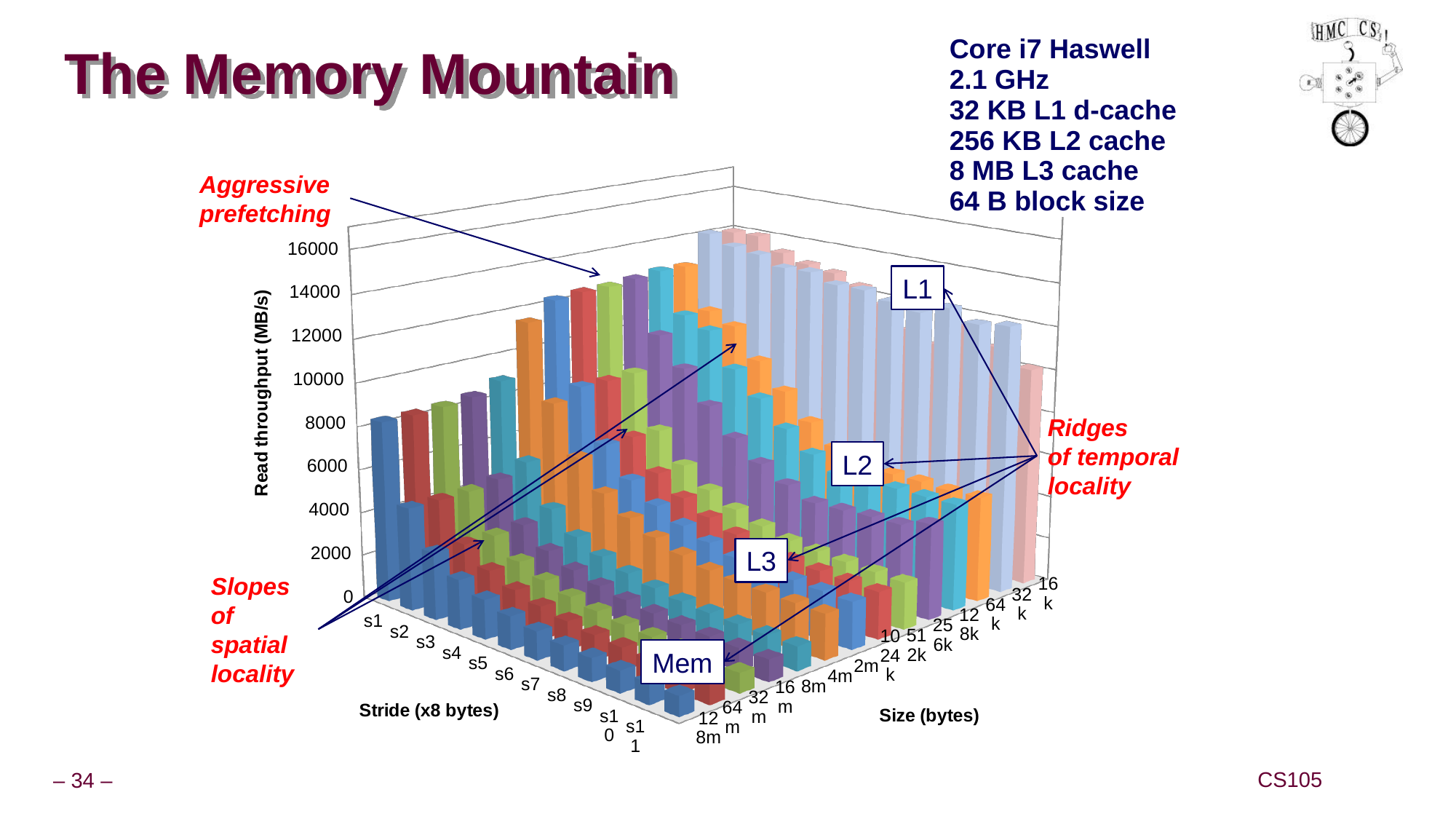
For the front-most size row, which has the larger read throughput: stride s1 or stride s11? s1 Is the read throughput for stride s1 at size 16k greater or less than 12000? greater How many stride categories are shown along the Stride (x8 bytes) axis? 11 Is the read throughput for stride s11 in the front-most size row greater or less than 2000? less For the front-most size row (largest working-set size), does read throughput rise or fall as stride increases from s1 to s11? fall What kind of chart is shown on the slide? 3D bar chart For the front-most size row, which stride has the highest read throughput? s1 What is the label of the vertical axis of the chart? Read throughput (MB/s) What is the highest tick value shown on the Read throughput (MB/s) axis? 16000 Is the read throughput for stride s1 in the front-most size row greater or less than 4000? greater